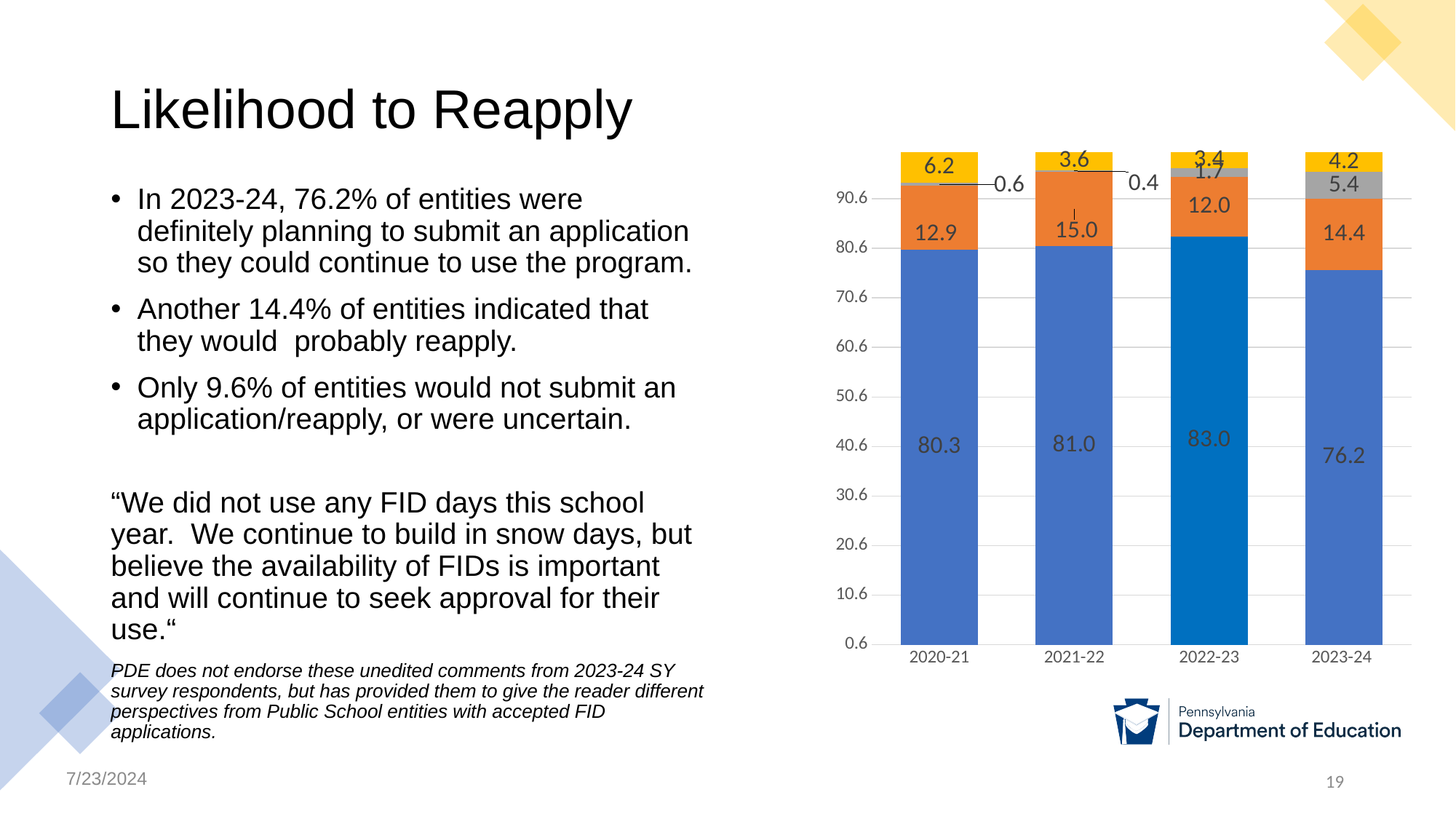
Which has the larger orange segment value, 2020-21 or 2021-22? 2021-22 What kind of chart is shown on the slide? Stacked bar chart What is the value of the gray segment for 2023-24? 5.4 What is the difference between the blue segment values for 2022-23 and 2023-24? 6.8 How many school years are shown on the x axis of the chart? 4 What is the value of the blue (bottom) segment for 2023-24? 76.2 How many segments make up each stacked bar in the chart? 4 Which school year has the lowest value for the blue (bottom) segment? 2023-24 What is the value of the yellow (top) segment for 2020-21? 6.2 Which school year has the highest value for the yellow (top) segment? 2020-21 What is the value of the orange segment for 2021-22? 15.0 Which school year has the highest value for the blue (bottom) segment? 2022-23